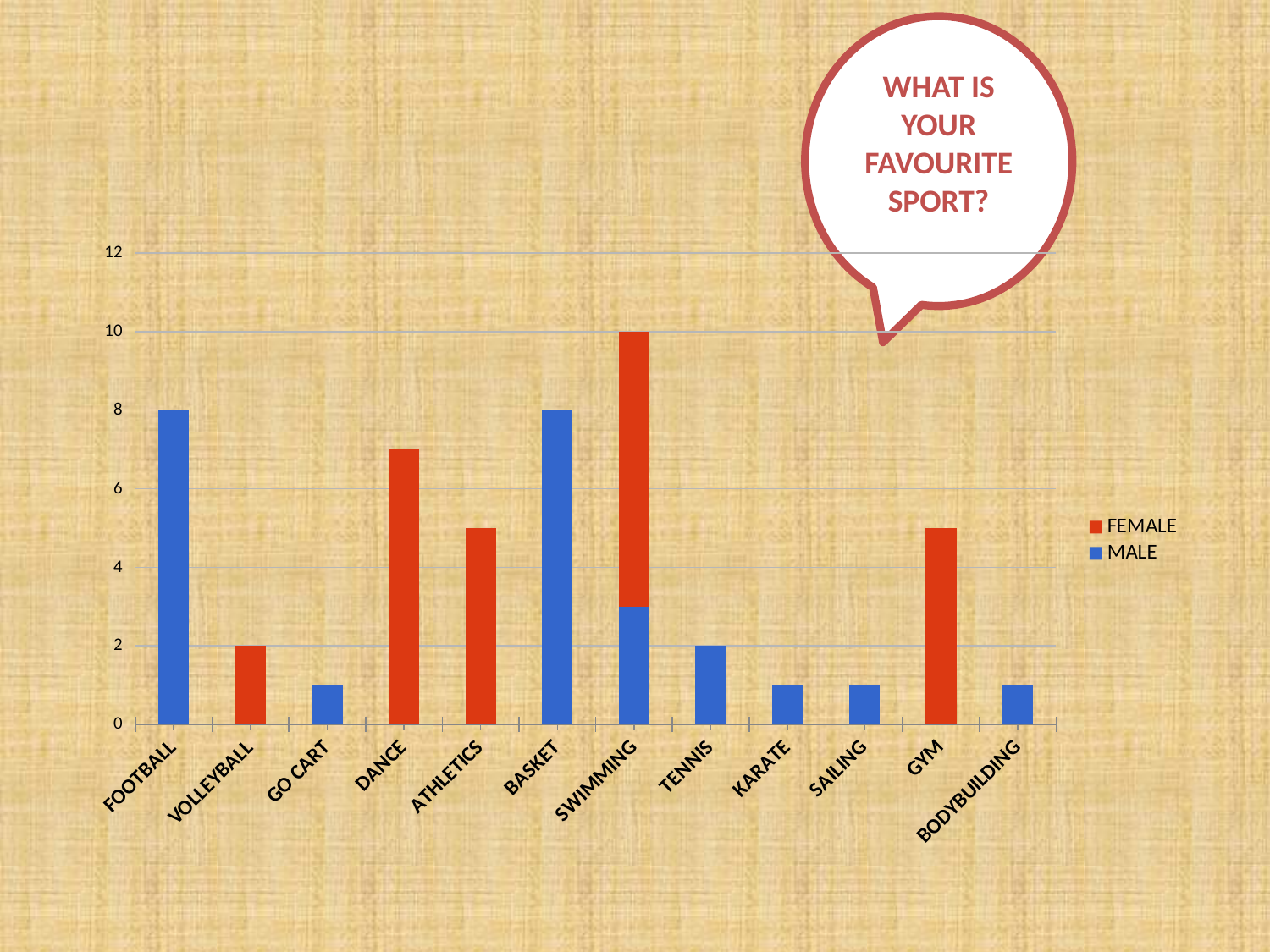
How many sport categories are shown on the x axis? 12 What is the total height of the stacked bar for SWIMMING? 10 Is the MALE value for KARATE greater or less than 2? less What is the MALE value for FOOTBALL? 8 How many series does the legend list? 2 What is the MALE value for BASKET? 8 Is the FEMALE value for DANCE greater or less than 6? greater What is the MALE value for TENNIS? 2 Which sport has the tallest bar overall? SWIMMING What is the difference between the MALE value for FOOTBALL and the MALE value for TENNIS? 6 What kind of chart is shown on the slide? bar chart What is the FEMALE value for VOLLEYBALL? 2